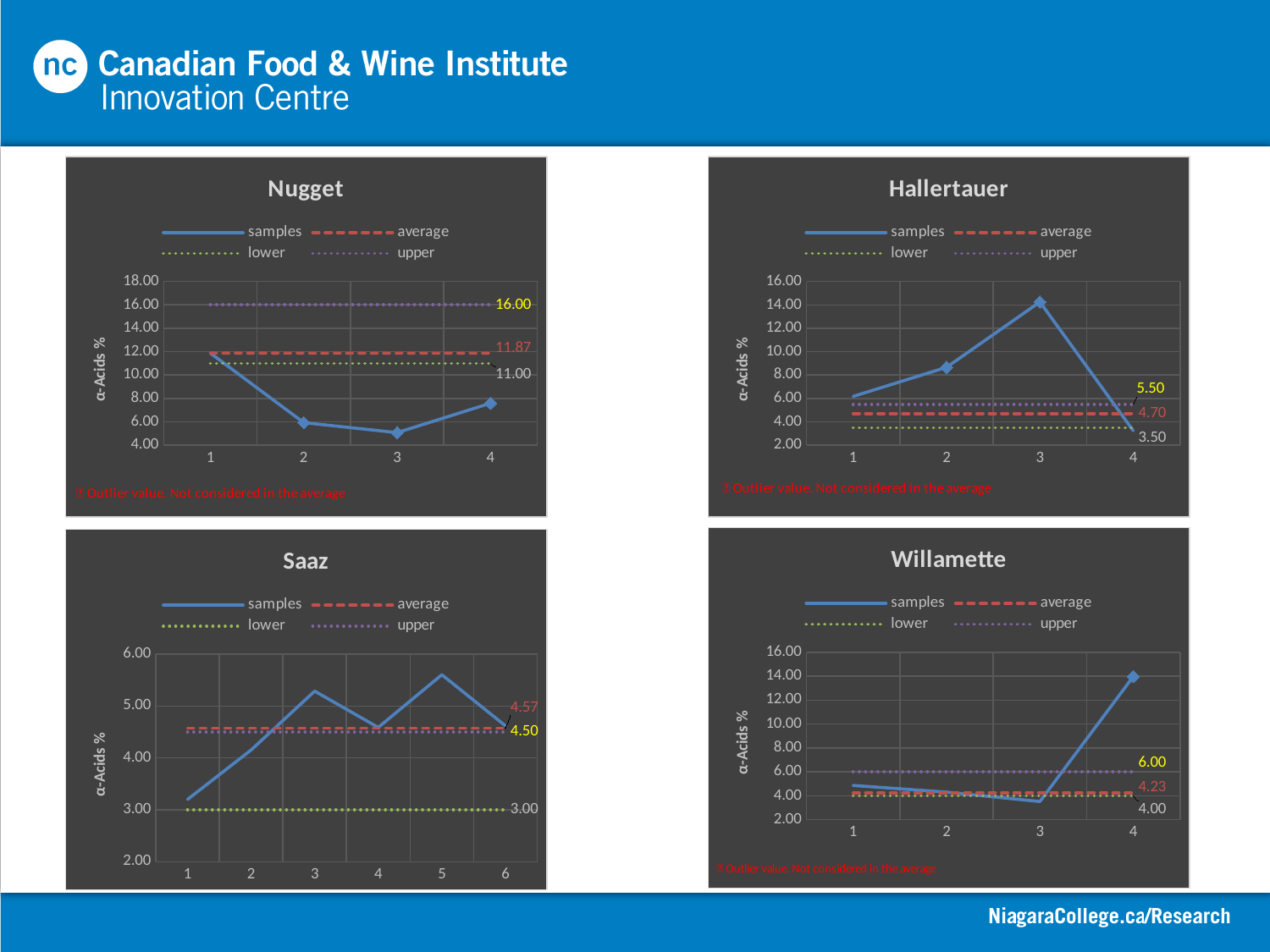
In the Hallertauer chart, what is the difference between the labelled upper value and the labelled lower value? 2.00 In the Nugget chart, which sample number has the lowest samples value? 3 In the Hallertauer chart, which sample number has the highest samples value? 3 How many series does the legend of the Hallertauer chart list? 4 In the Hallertauer chart, what is the labelled lower value? 3.50 In the Nugget chart, what value is labelled for the upper line? 16.00 In the Saaz chart, what is the labelled average value? 4.57 In the Willamette chart, is the samples value for sample 4 greater or less than 12.00? greater In the Willamette chart, what value is labelled for the upper line? 6.00 What kind of chart is the Willamette chart? line chart In the Nugget chart, what is the labelled average value? 11.87 How many sample points are plotted in the Saaz chart? 6